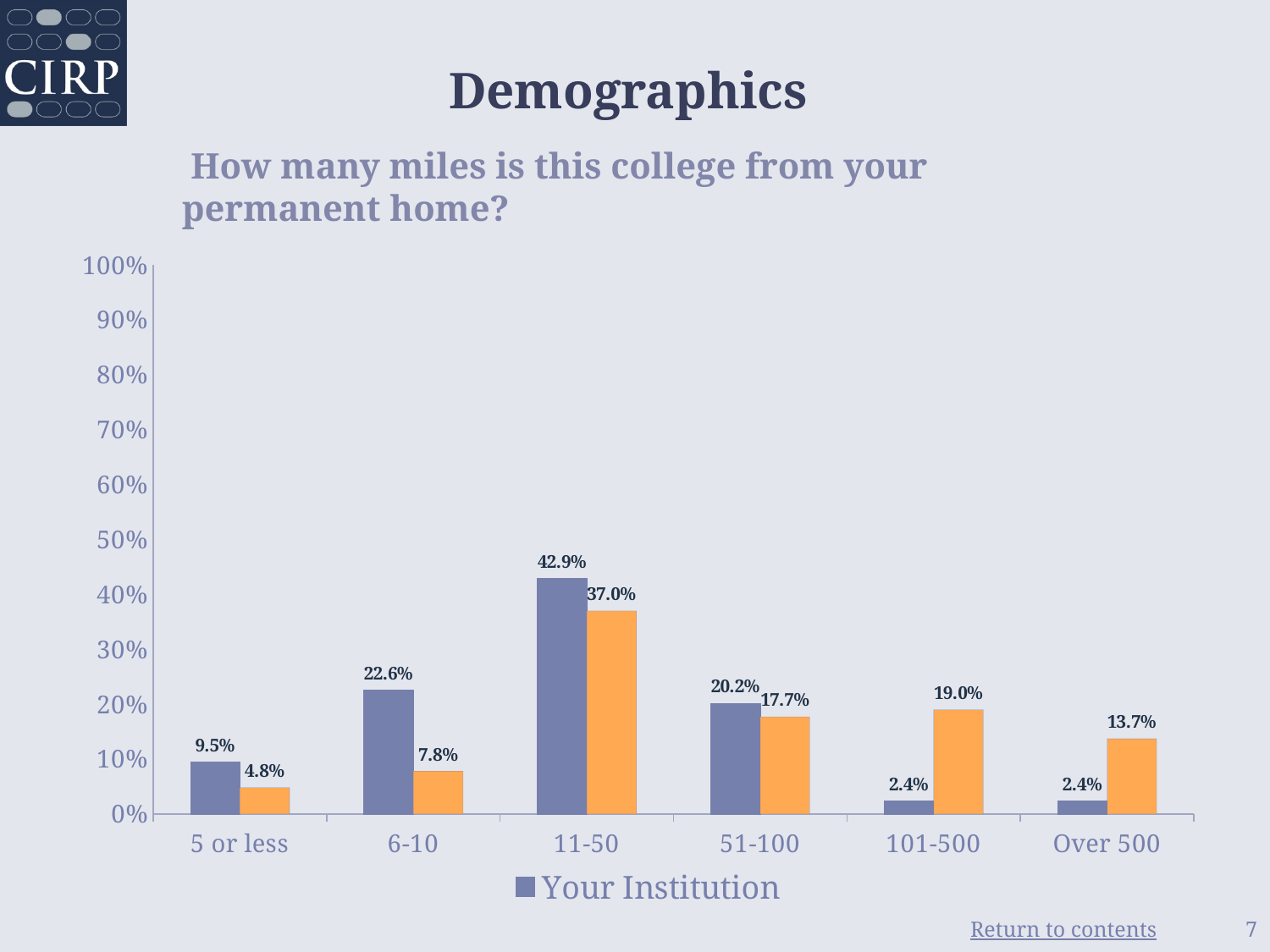
Which category has the highest value for Your Institution? 11-50 What is the value of the orange bar in the 101-500 category? 19.0% What is the value for Your Institution in the 5 or less category? 9.5% What is the value for Your Institution in the 6-10 category? 22.6% Which category has the lowest value for the orange bars? 5 or less How many categories are shown on the x axis? 6 Is the value for Your Institution in the 51-100 category greater or less than 30%? less In the Over 500 category, which is larger: the Your Institution bar or the orange bar? the orange bar How many series does the legend list? 1 What is the value for Your Institution in the 11-50 category? 42.9% What kind of chart is shown on the slide? bar chart What is the difference between the Your Institution value and the orange bar value in the 11-50 category? 5.9%